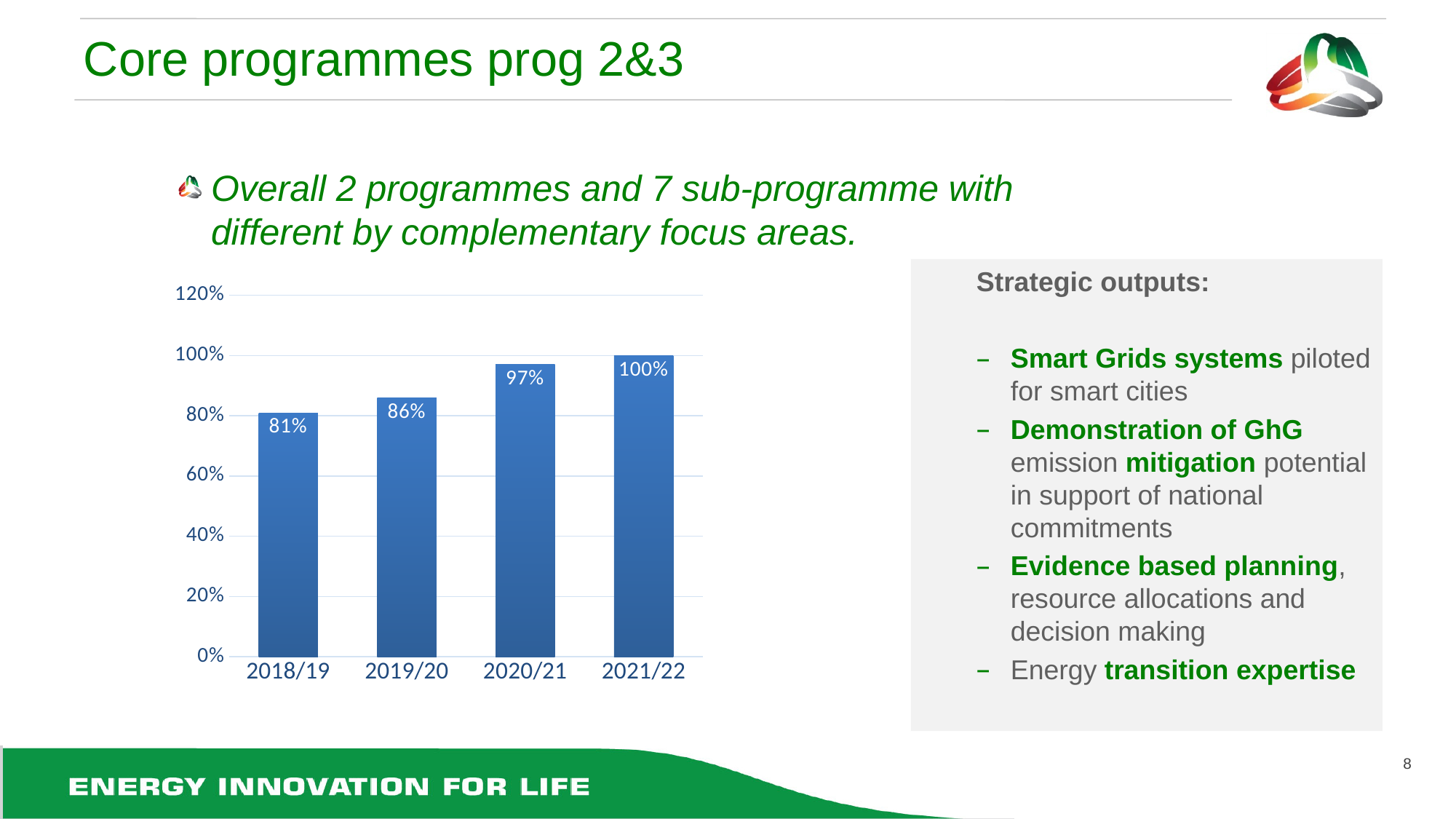
What is the value for 2019/20? 86% What is the value for 2018/19? 81% Which year has the lowest value? 2018/19 Which is larger, the value for 2019/20 or the value for 2020/21? 2020/21 What is the value for 2021/22? 100% What is the difference between the values for 2020/21 and 2019/20? 11% What kind of chart is shown on the slide? Bar chart What is the difference between the values for 2021/22 and 2018/19? 19% Do the values rise or fall from 2018/19 to 2021/22? Rise What is the value for 2020/21? 97% Which year has the highest value? 2021/22 How many years are shown on the x axis of the chart? 4